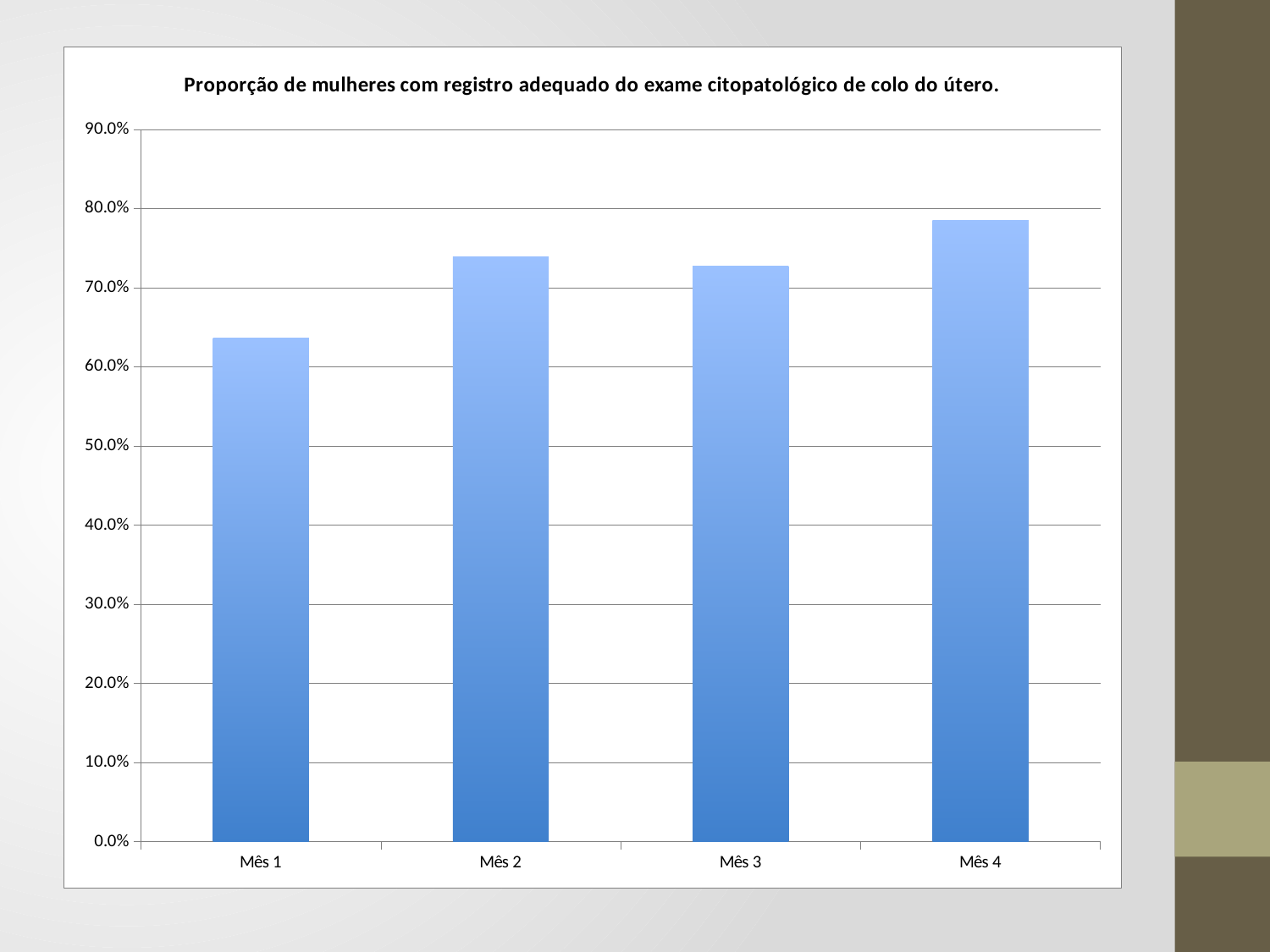
Which month has the lowest proportion? Mês 1 Is the value for Mês 2 greater or less than 70.0%? greater Which is larger, the value for Mês 1 or the value for Mês 4? Mês 4 Is the value for Mês 4 greater or less than 80.0%? less What is the title of the chart? Proporção de mulheres com registro adequado do exame citopatológico de colo do útero. How many categories (months) are plotted on the chart? 4 Is the value for Mês 1 greater or less than 60.0%? greater Which month has the highest proportion? Mês 4 What kind of chart is shown on the slide? bar chart From Mês 3 to Mês 4, does the value rise or fall? rise